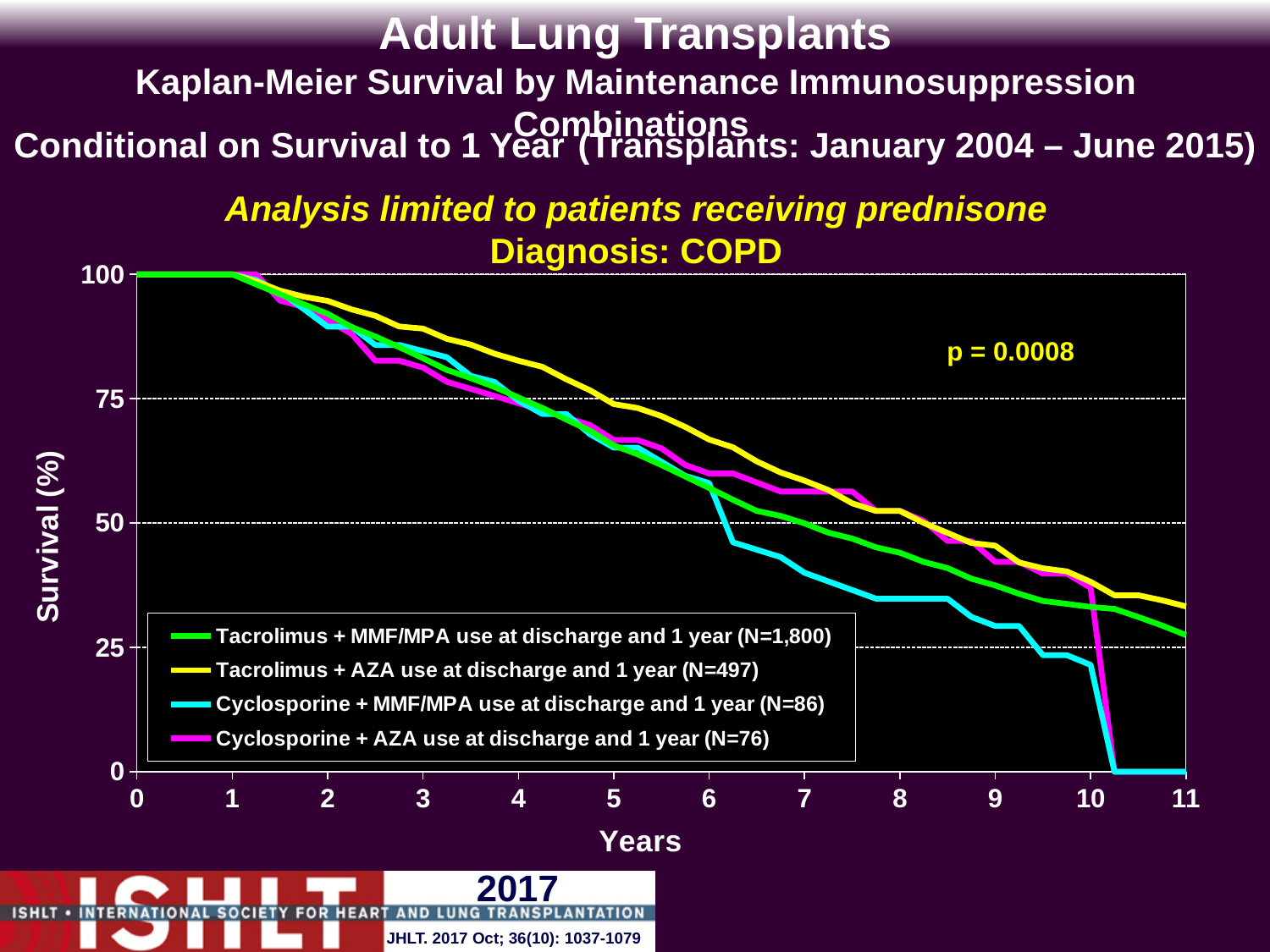
Is the survival (%) for Tacrolimus + AZA use at discharge and 1 year at year 6 greater or less than 50? greater Which series has the lowest survival (%) at year 7? Cyclosporine + MMF/MPA use at discharge and 1 year (N=86) Is the survival (%) for Tacrolimus + MMF/MPA use at discharge and 1 year at year 10 greater or less than 25? greater Do the survival curves rise or fall as the years increase? fall At year 7, which has the higher survival (%): Tacrolimus + MMF/MPA use at discharge and 1 year or Cyclosporine + MMF/MPA use at discharge and 1 year? Tacrolimus + MMF/MPA use at discharge and 1 year What p-value is printed on the chart? p = 0.0008 How many series does the legend list? 4 What kind of chart is shown on the slide? line chart Is the survival (%) for Cyclosporine + MMF/MPA use at discharge and 1 year at year 7 greater or less than 50? less What is the survival (%) for Tacrolimus + AZA use at discharge and 1 year at year 0? 100 Which series has the highest survival (%) at year 6? Tacrolimus + AZA use at discharge and 1 year (N=497)